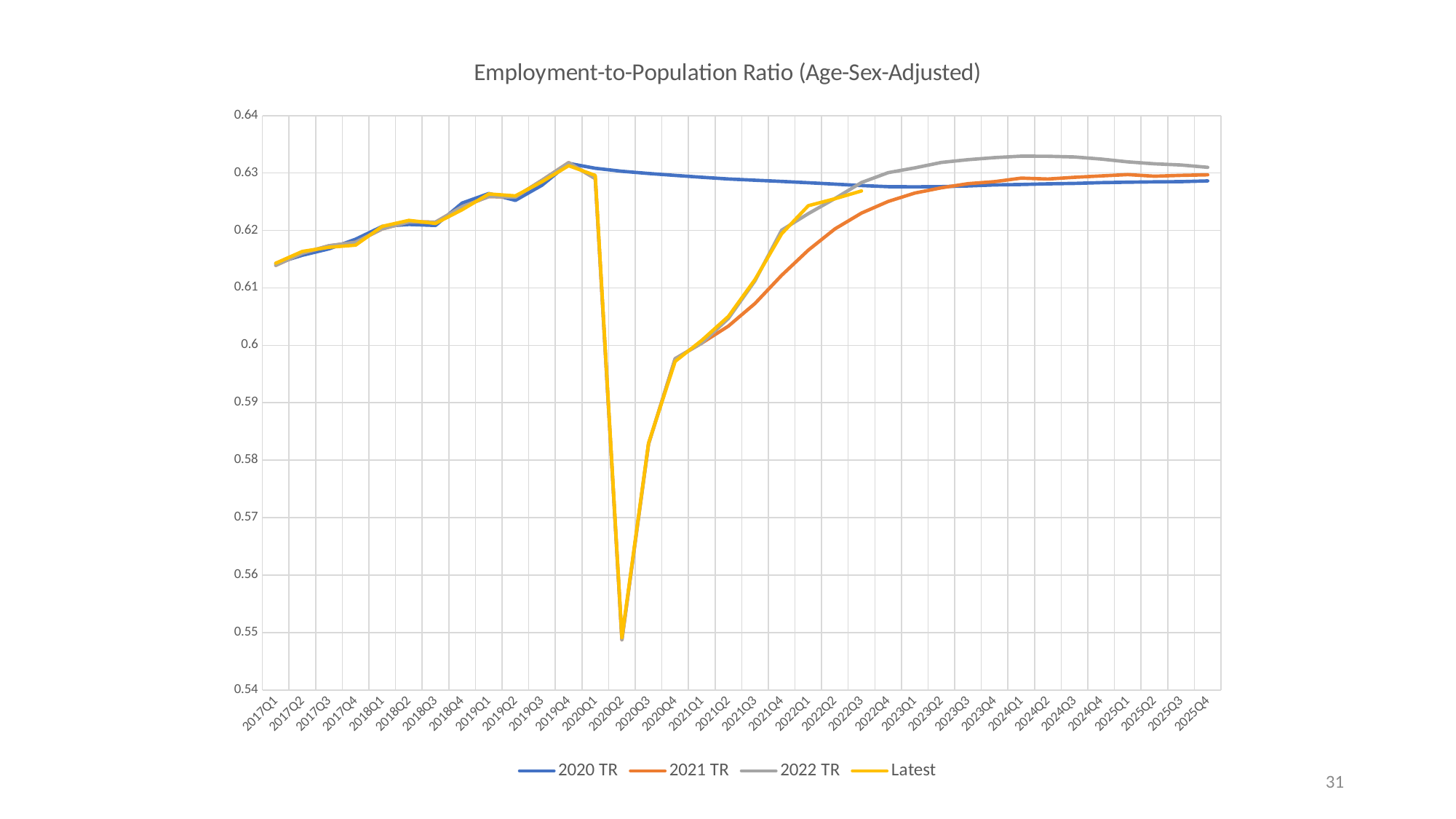
Does the 2020 TR series rise or fall from 2020Q1 to 2025Q4? Fall What is the title of the chart? Employment-to-Population Ratio (Age-Sex-Adjusted) Is the value of the 2022 TR series at 2024Q1 greater or less than 0.63? greater At 2024Q1, which series is higher: 2022 TR or 2020 TR? 2022 TR In which quarter does the Latest series reach its lowest value? 2020Q2 Is the value of the Latest series at 2020Q2 greater or less than 0.56? less Does the Latest series rise or fall from 2017Q1 to 2019Q4? Rise How many series does the legend list? 4 Which series are listed in the legend? 2020 TR, 2021 TR, 2022 TR, Latest Is the value of the 2021 TR series at 2021Q3 greater or less than 0.61? less What kind of chart is shown on the slide? Line chart How many quarters are labelled along the x axis? 36